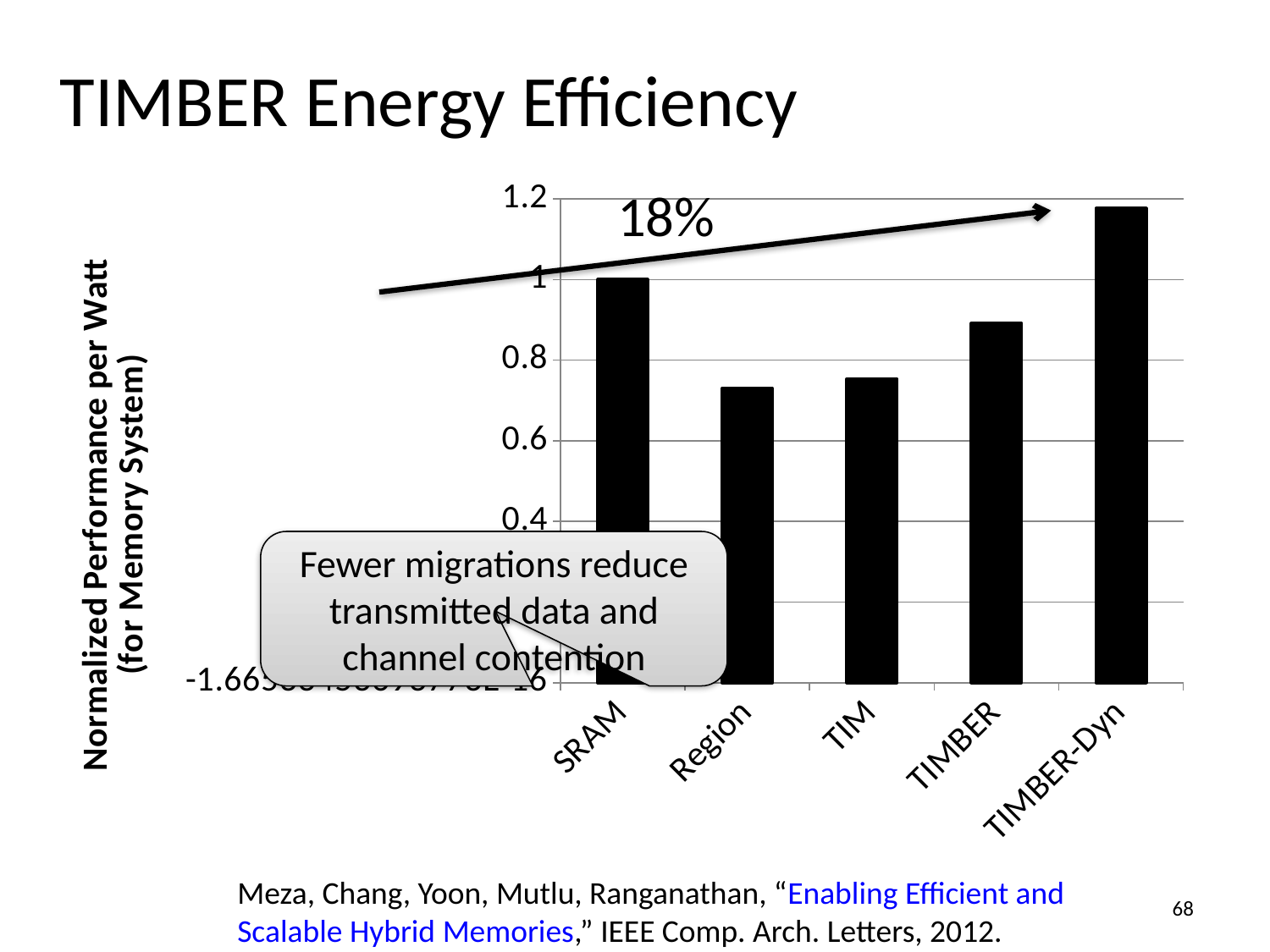
What is the label of the y axis of the chart? Normalized Performance per Watt (for Memory System) What kind of chart is shown on the slide? bar chart Is the value for Region greater or less than 0.6? greater Which has a larger value, TIMBER or TIM? TIMBER Is the value for TIM greater or less than 0.8? less What is the normalized performance per watt for SRAM? 1 How many categories are shown on the x axis of the chart? 5 Which category has the highest normalized performance per watt? TIMBER-Dyn Is the value for TIMBER greater or less than 0.8? greater Which has a larger value, SRAM or Region? SRAM